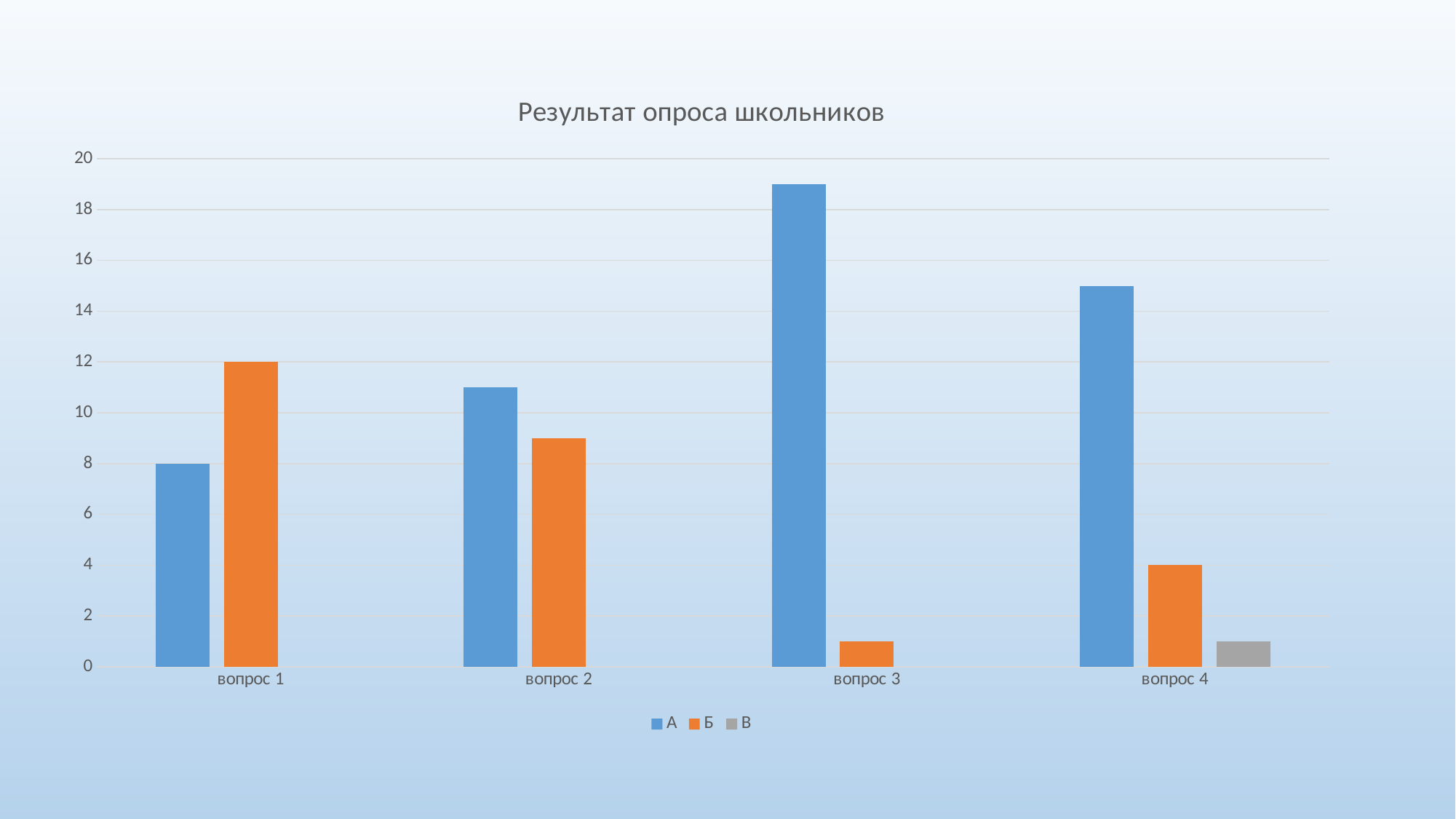
Is the value of series A for вопрос 2 greater or less than 10? greater Is the value of series A for вопрос 3 greater or less than 18? greater For вопрос 1, how much larger is the value of Б than the value of A? 4 How many questions (categories) are shown on the x axis? 4 Is the value of series В for вопрос 4 greater or less than 2? less What is the value of series A for вопрос 1? 8 For which question does series A have its highest value? вопрос 3 For вопрос 1, which series has the larger value, A or Б? Б What is the value of series Б for вопрос 4? 4 How many series does the legend list? 3 For which question does series Б have its lowest value? вопрос 3 What is the value of series Б for вопрос 1? 12